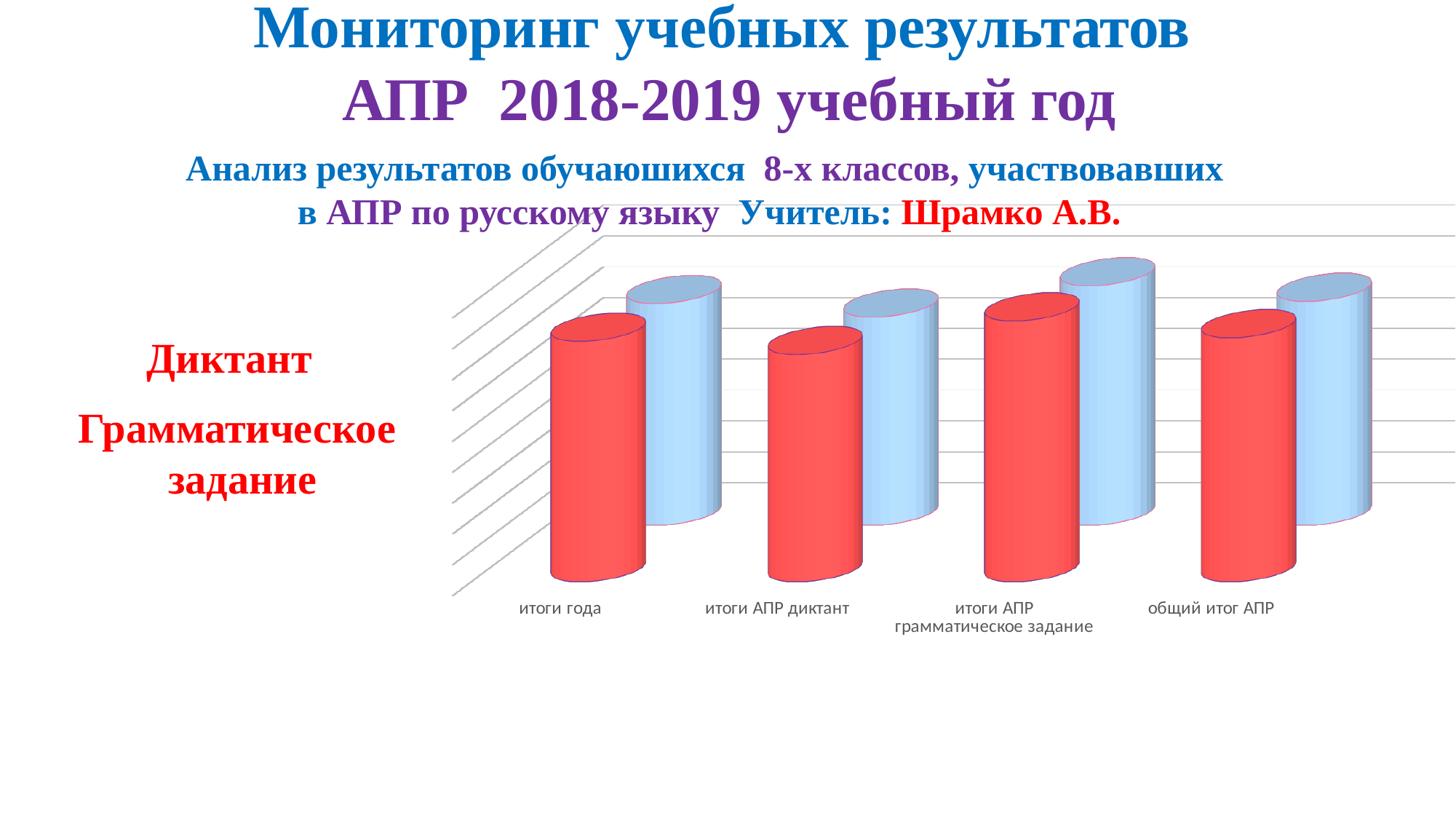
How many bars are plotted for each category in the chart? 2 Among the red bars, which category has the shortest bar? итоги АПР диктант For the red bars, which is taller: итоги АПР диктант or итоги АПР грамматическое задание? итоги АПР грамматическое задание Among the red bars, which category has the tallest bar? итоги АПР грамматическое задание What kind of chart is shown on the slide? bar chart What is the label of the last category on the x axis of the chart? общий итог АПР How many categories are shown along the x axis of the chart? 4 What is the label of the first category on the x axis of the chart? итоги года Among the blue bars, which category has the tallest bar? итоги АПР грамматическое задание Among the blue bars, which category has the shortest bar? итоги АПР диктант For the blue bars, which is taller: итоги АПР диктант or итоги АПР грамматическое задание? итоги АПР грамматическое задание